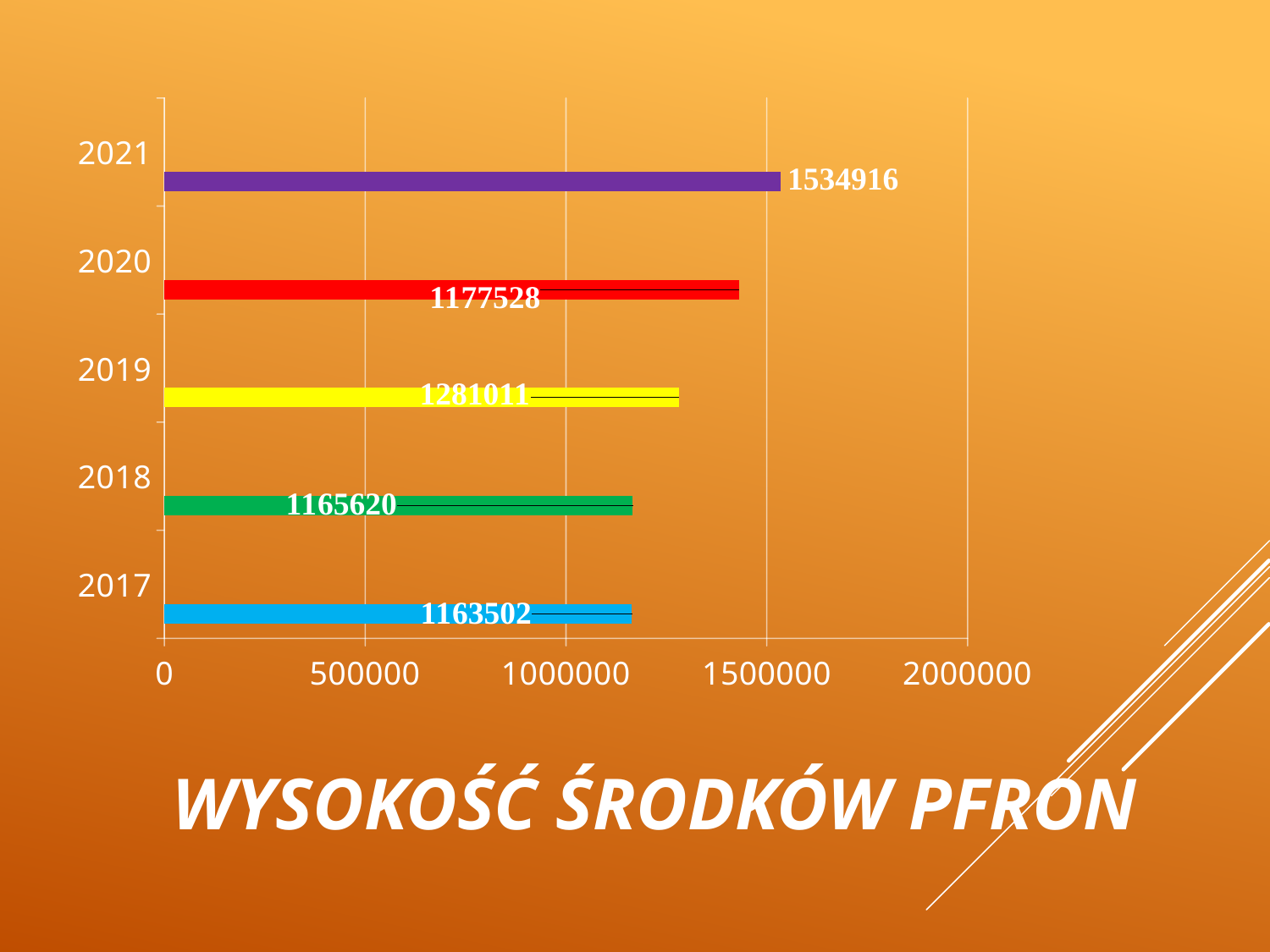
How many years are shown on the chart? 5 What is the value for 2017? 1163502 Which is larger, the value for 2021 or the value for 2019? 2021 What kind of chart is shown on the slide? bar chart Which year has the highest value? 2021 What is the value for 2019? 1281011 What is the value for 2018? 1165620 What is the difference between the values for 2021 and 2019? 253905 Is the value for 2017 greater or less than 1000000? greater What is the value for 2021? 1534916 What is the difference between the values for 2021 and 2017? 371414